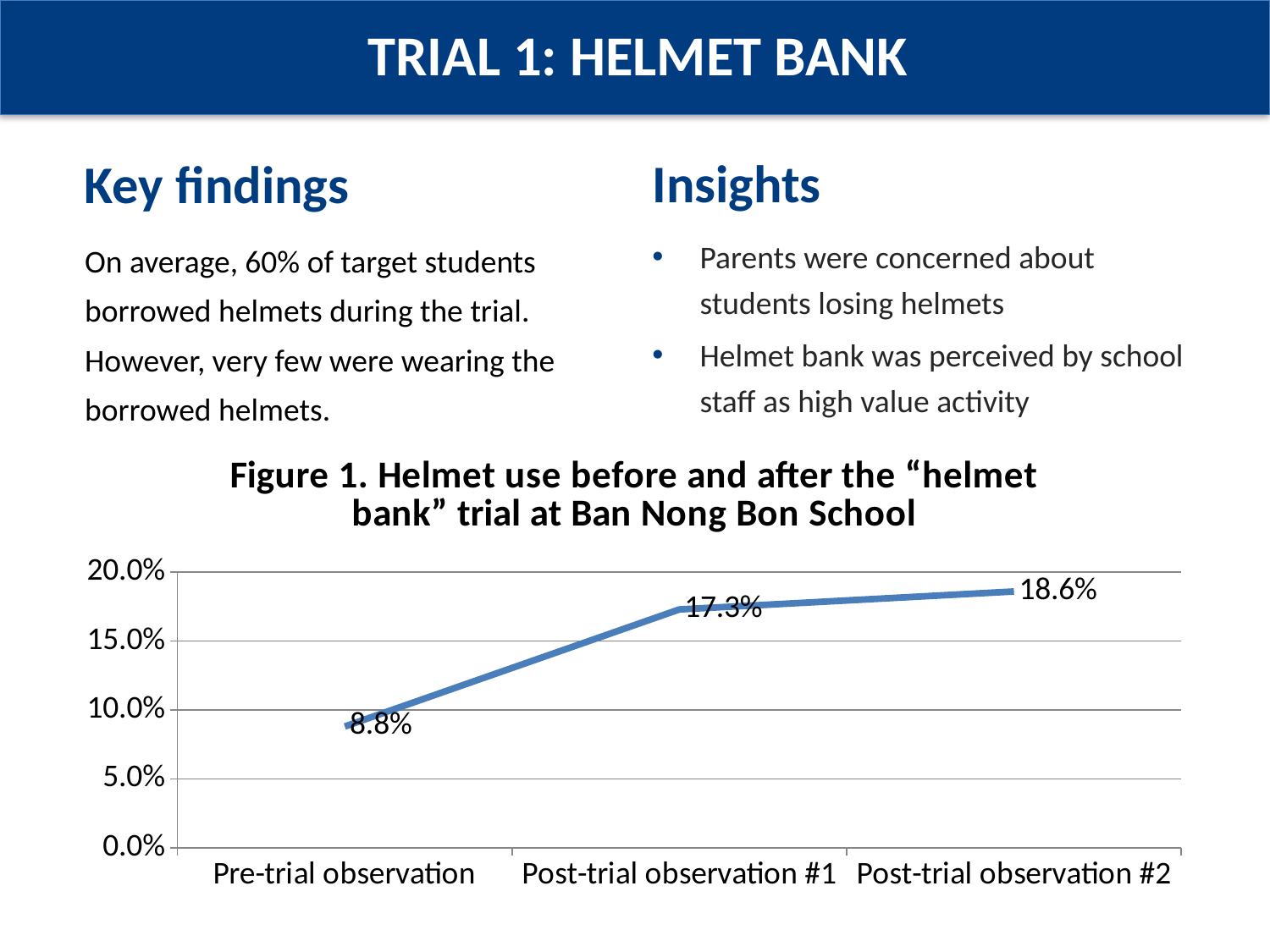
Which observation has the lowest helmet use value? Pre-trial observation Is the value for the Pre-trial observation greater or less than 10.0%? less How many observation points are plotted on the chart? 3 What kind of chart is shown on the slide? line chart What is the helmet use value for Post-trial observation #1? 17.3% Do the helmet use values rise or fall from the Pre-trial observation to Post-trial observation #2? rise Which is larger, the value for the Pre-trial observation or the value for Post-trial observation #1? Post-trial observation #1 What is the helmet use value for the Pre-trial observation? 8.8% Which observation has the highest helmet use value? Post-trial observation #2 What is the helmet use value for Post-trial observation #2? 18.6% What is the difference in helmet use between Post-trial observation #2 and Post-trial observation #1? 1.3% What is the difference in helmet use between Post-trial observation #1 and the Pre-trial observation? 8.5%